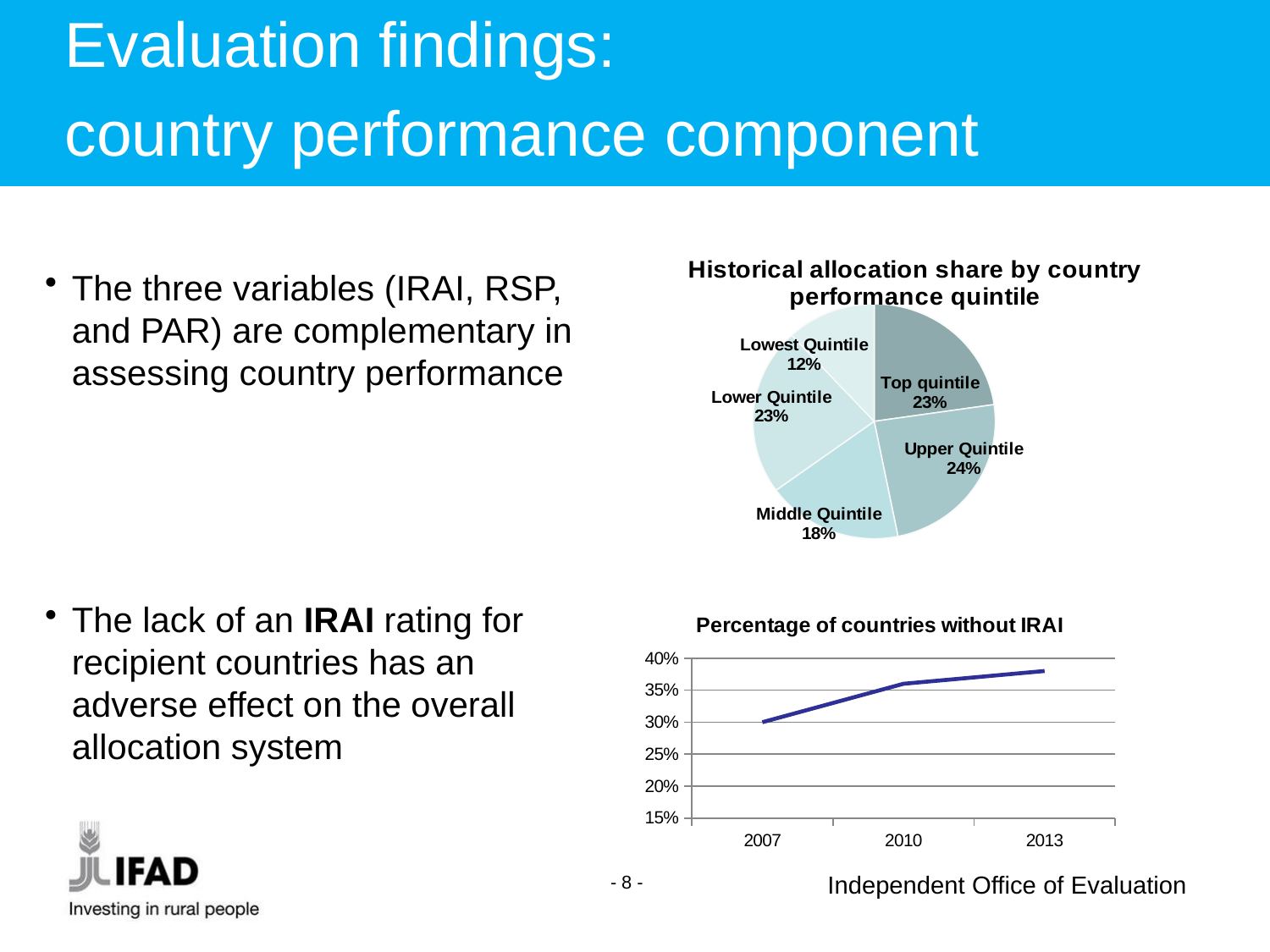
In the pie chart 'Historical allocation share by country performance quintile', what share does the Middle Quintile have? 18% In the pie chart 'Historical allocation share by country performance quintile', what share does the Upper Quintile have? 24% In the pie chart 'Historical allocation share by country performance quintile', how many slices are there? 5 In the chart 'Percentage of countries without IRAI', is the value for 2013 greater or less than 35%? greater In the chart 'Percentage of countries without IRAI', do the values rise or fall from 2007 to 2013? Rise What kind of chart is 'Historical allocation share by country performance quintile'? Pie chart In the pie chart 'Historical allocation share by country performance quintile', which quintile has the largest share? Upper Quintile In the pie chart 'Historical allocation share by country performance quintile', which quintile has the smallest share? Lowest Quintile In the pie chart 'Historical allocation share by country performance quintile', what share does the Lowest Quintile have? 12% What kind of chart is 'Percentage of countries without IRAI'? Line chart In the chart 'Percentage of countries without IRAI', is the value for 2007 greater or less than 35%? less In the pie chart 'Historical allocation share by country performance quintile', what is the difference between the Upper Quintile share and the Lowest Quintile share? 12%